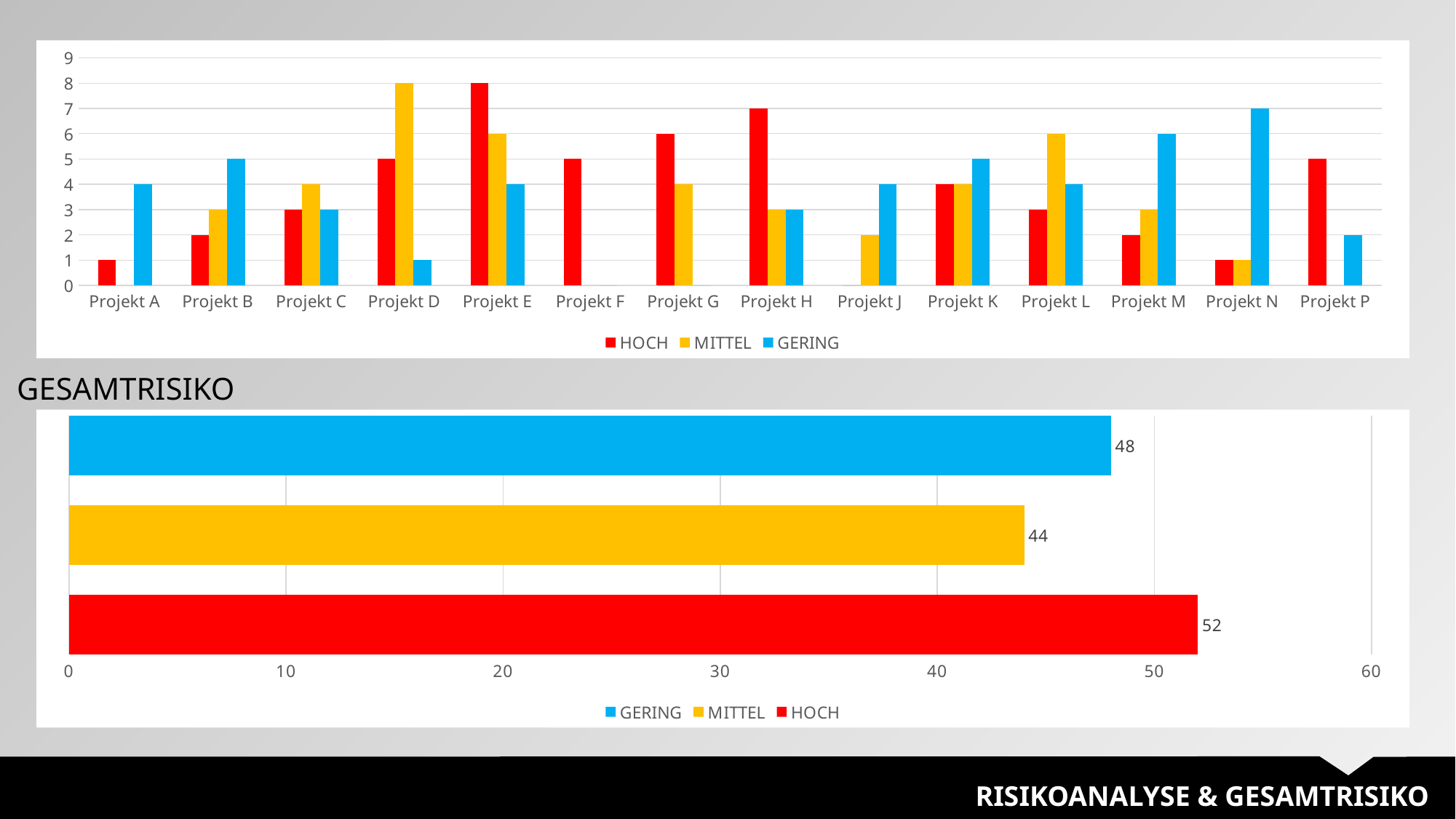
In the top chart, how many projects are shown on the x axis? 14 In the top chart, is the HOCH value for Projekt H larger than the HOCH value for Projekt A? Yes In the GESAMTRISIKO chart, which category has the lowest value? MITTEL In the GESAMTRISIKO chart, what is the value for MITTEL? 44 In the GESAMTRISIKO chart, which category has the highest value? HOCH In the GESAMTRISIKO chart, what is the value for HOCH? 52 In the top chart, how many series does the legend list? 3 In the top chart, which project has the highest GERING value? Projekt N In the GESAMTRISIKO chart, what is the difference between the HOCH and GERING values? 4 In the GESAMTRISIKO chart, is the value for GERING greater or less than 50? less What kind of chart is the GESAMTRISIKO chart? bar chart In the top chart, what is the HOCH value for Projekt E? 8